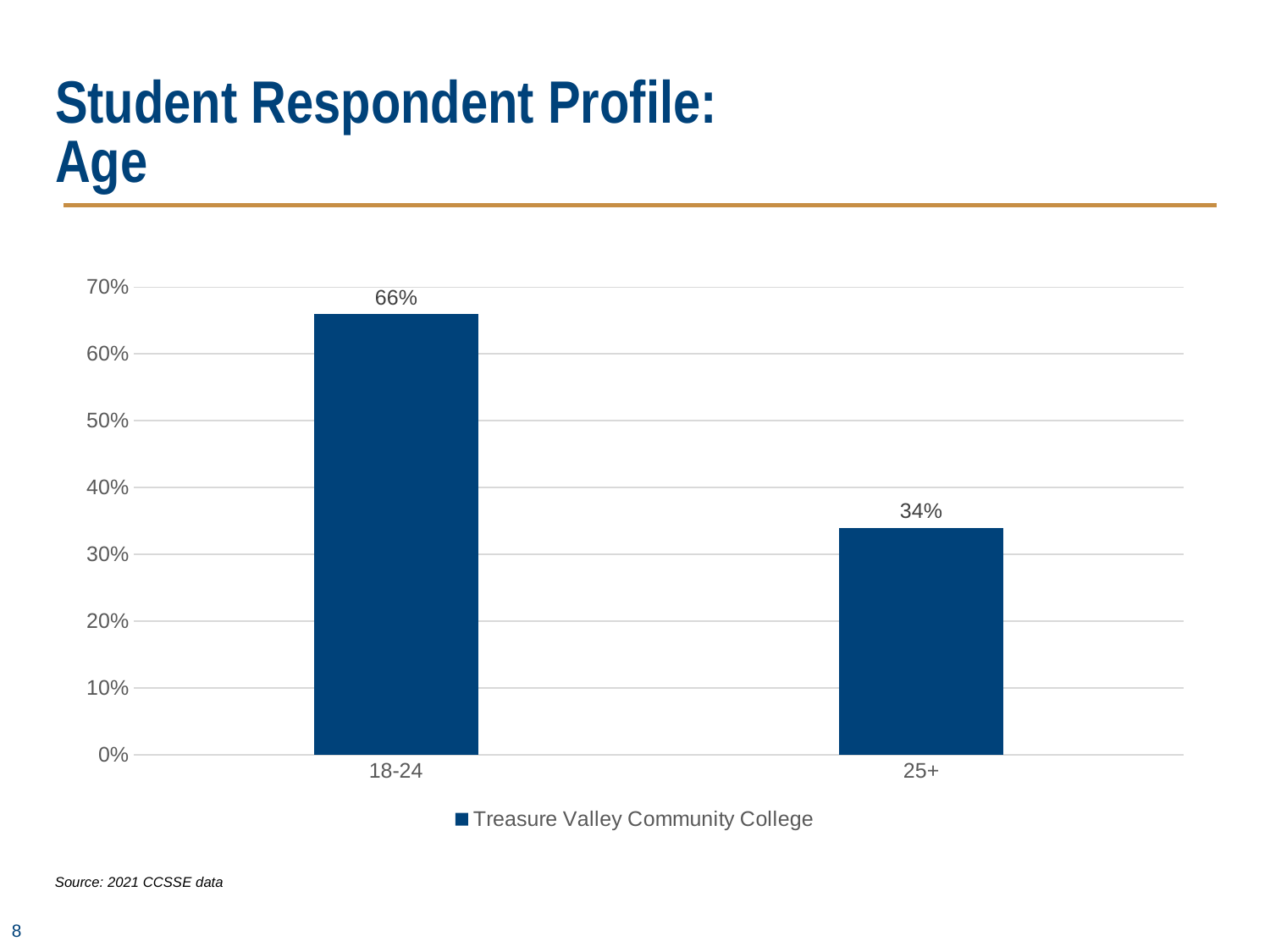
Which age group has the lowest share of respondents? 25+ How many age categories are shown on the chart? 2 What kind of chart is shown on the slide? bar chart Which is larger, the value for 18-24 or the value for 25+? 18-24 Is the value for 25+ greater or less than 40%? less What percentage of respondents are aged 18-24? 66% What percentage of respondents are aged 25+? 34% What is the difference in percentage points between the 18-24 and 25+ age groups? 32 How many series does the legend list? 1 Which age group has the highest share of respondents? 18-24 What series name is shown in the chart legend? Treasure Valley Community College Is the value for 18-24 greater or less than 60%? greater